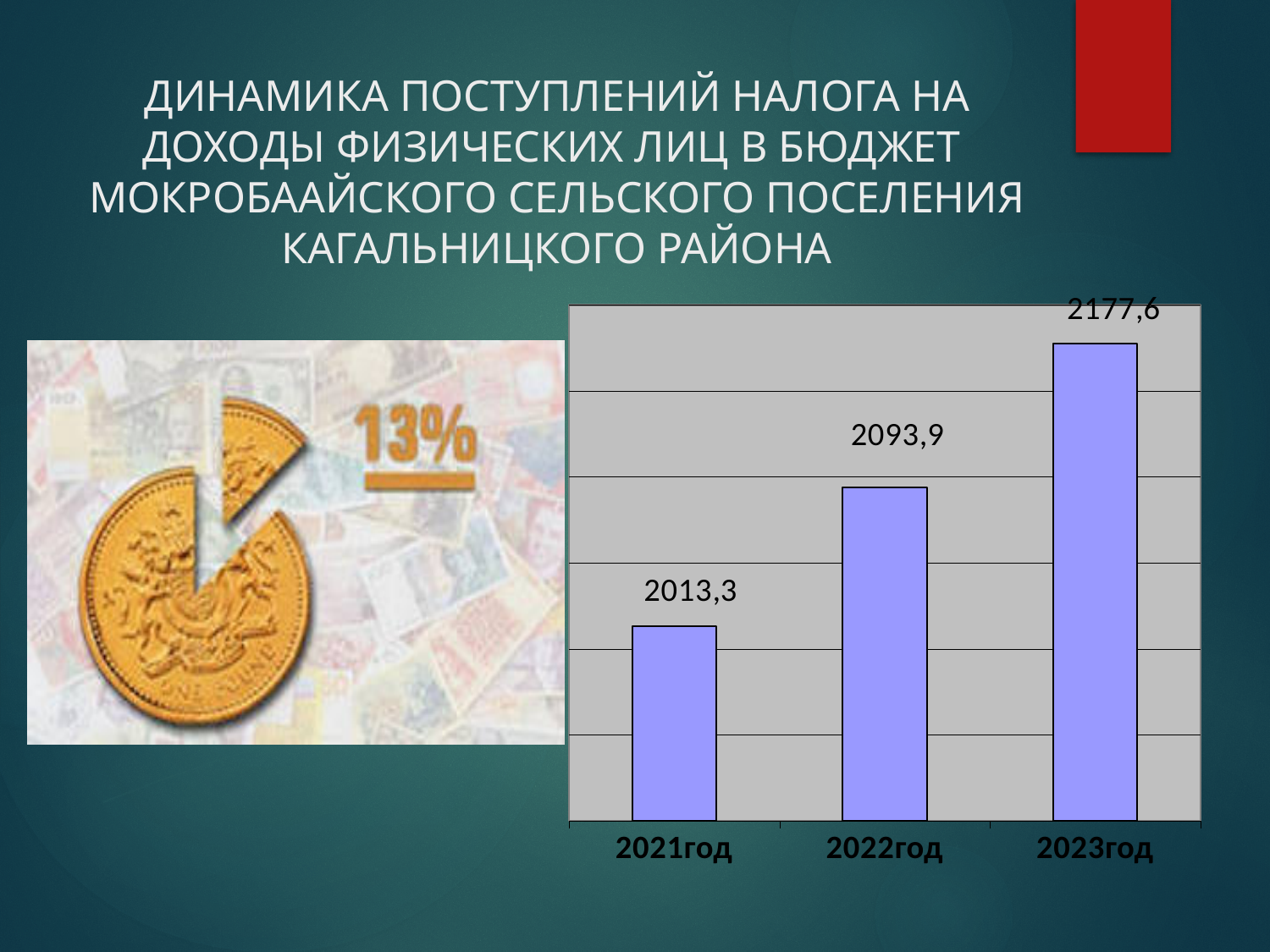
Which is larger, the value for 2022год or the value for 2023год? 2023год What is the difference between the values for 2023год and 2021год? 164,3 Do the values rise or fall from 2021год to 2023год? rise How many bars are shown in the chart? 3 What is the difference between the values for 2023год and 2022год? 83,7 What is the value shown for 2021год? 2013,3 What is the value shown for 2023год? 2177,6 What kind of chart is shown on the slide? bar chart Which year has the lowest value in the chart? 2021год Which year has the highest value in the chart? 2023год What is the value shown for 2022год? 2093,9 What is the difference between the values for 2022год and 2021год? 80,6